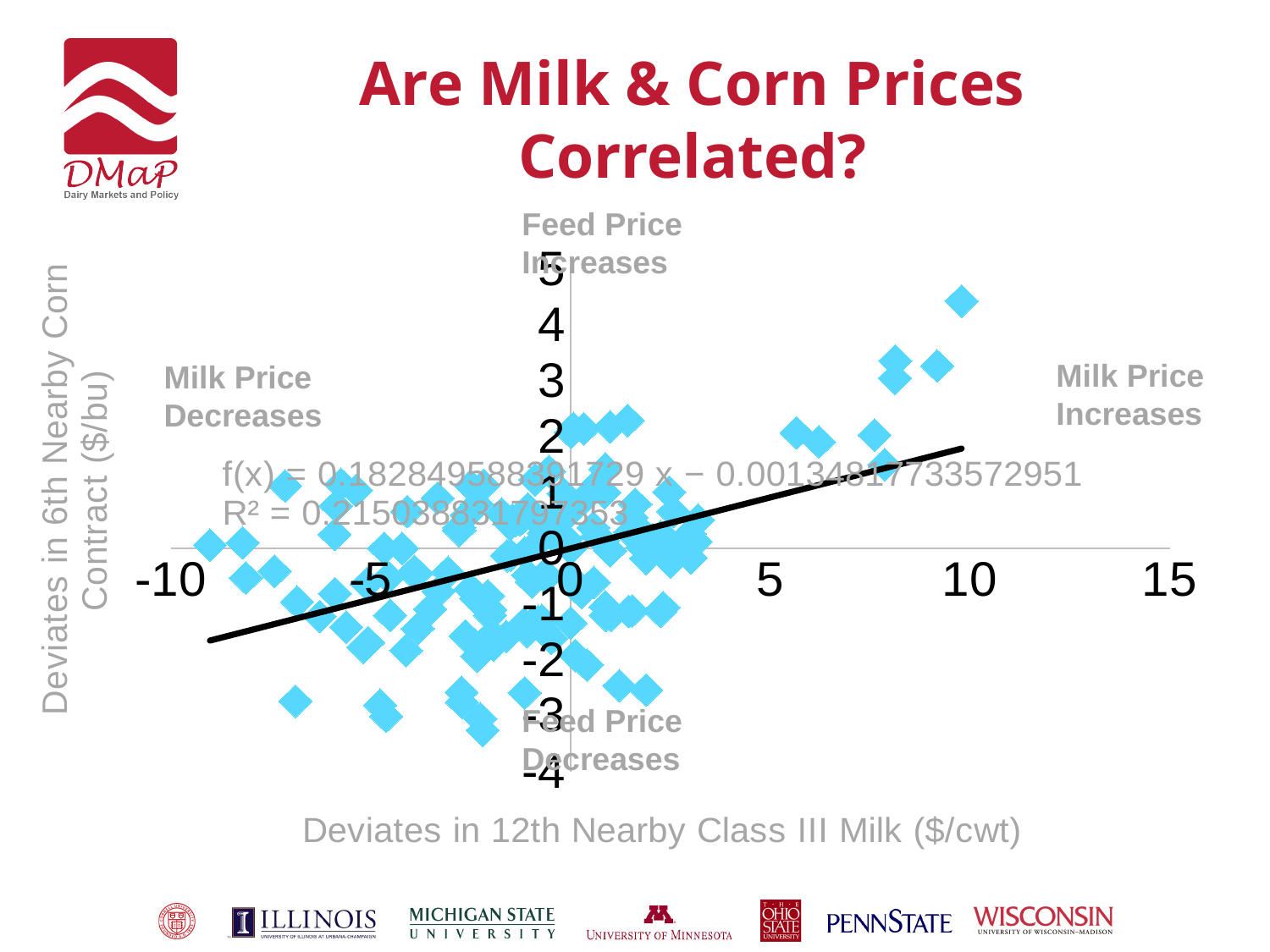
What is the R² value shown on the chart? 0.2150388831797353 Is the horizontal-axis value of the highest point in the chart greater or less than 5? greater What is the label of the horizontal axis of the chart? Deviates in 12th Nearby Class III Milk ($/cwt) Does the trend line in the chart rise or fall as the x-axis values increase? Rise Is the vertical-axis value of the lowest point in the chart greater or less than -3? less What is the title of the chart on the slide? Are Milk & Corn Prices Correlated? Is the R² value of the fitted line greater or less than 0.5? less What is the smallest value shown on the vertical axis of the chart? -4 What kind of chart is shown on the slide? Scatter chart What is the largest value shown on the horizontal axis of the chart? 15